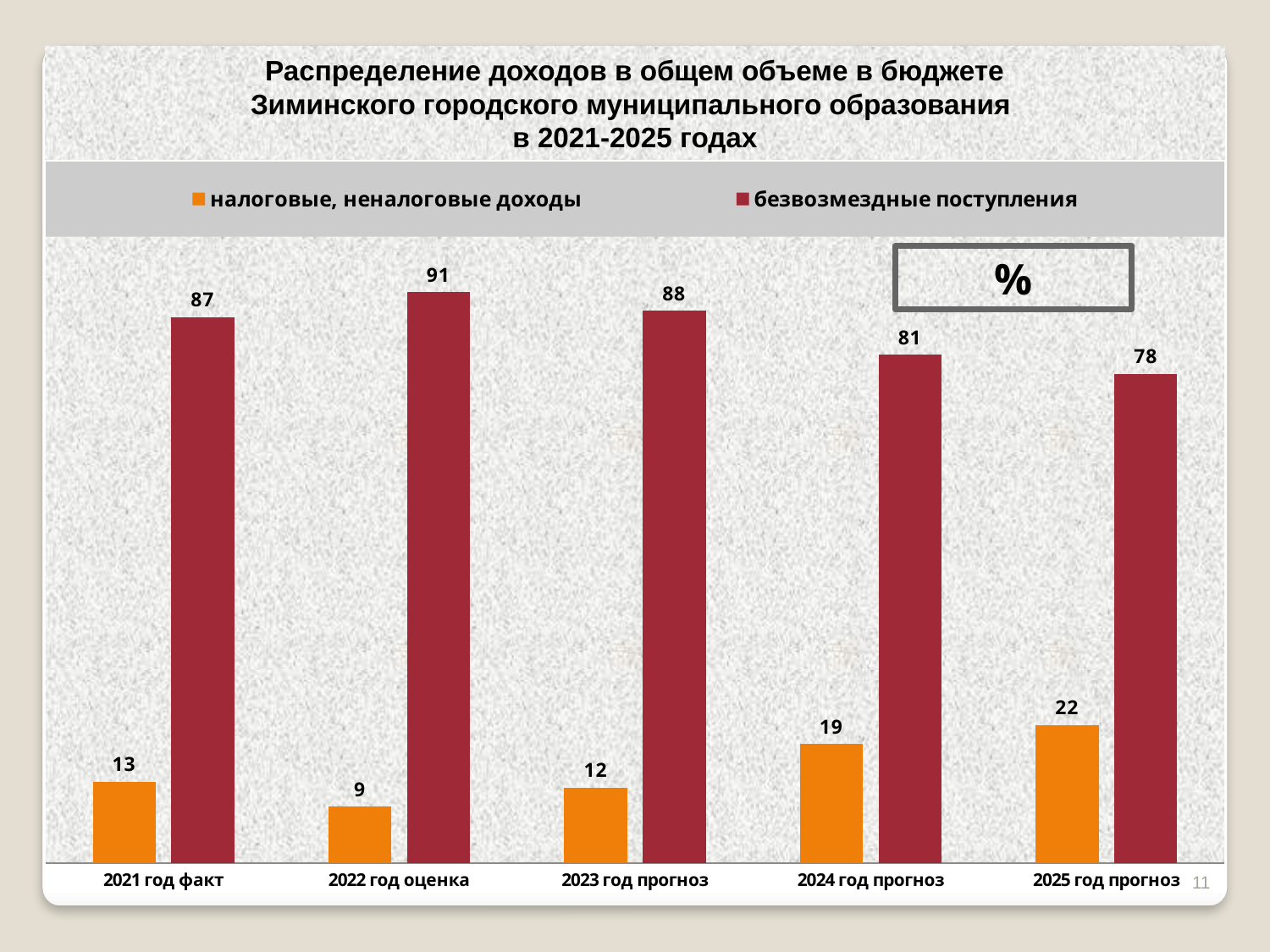
In which year is налоговые, неналоговые доходы lowest? 2022 год оценка What is the difference between безвозмездные поступления and налоговые, неналоговые доходы in 2024 год прогноз? 62 What colour are the bars for безвозмездные поступления? dark red What is the value for налоговые, неналоговые доходы in 2021 год факт? 13 Do the values for безвозмездные поступления rise or fall from 2022 год оценка to 2025 год прогноз? fall Which is larger: налоговые, неналоговые доходы in 2023 год прогноз or in 2025 год прогноз? 2025 год прогноз How many year categories are shown on the x axis? 5 How many series does the legend list? 2 What is the value for безвозмездные поступления in 2022 год оценка? 91 What kind of chart is shown on the slide? bar chart What is the value for налоговые, неналоговые доходы in 2025 год прогноз? 22 In which year is безвозмездные поступления highest? 2022 год оценка